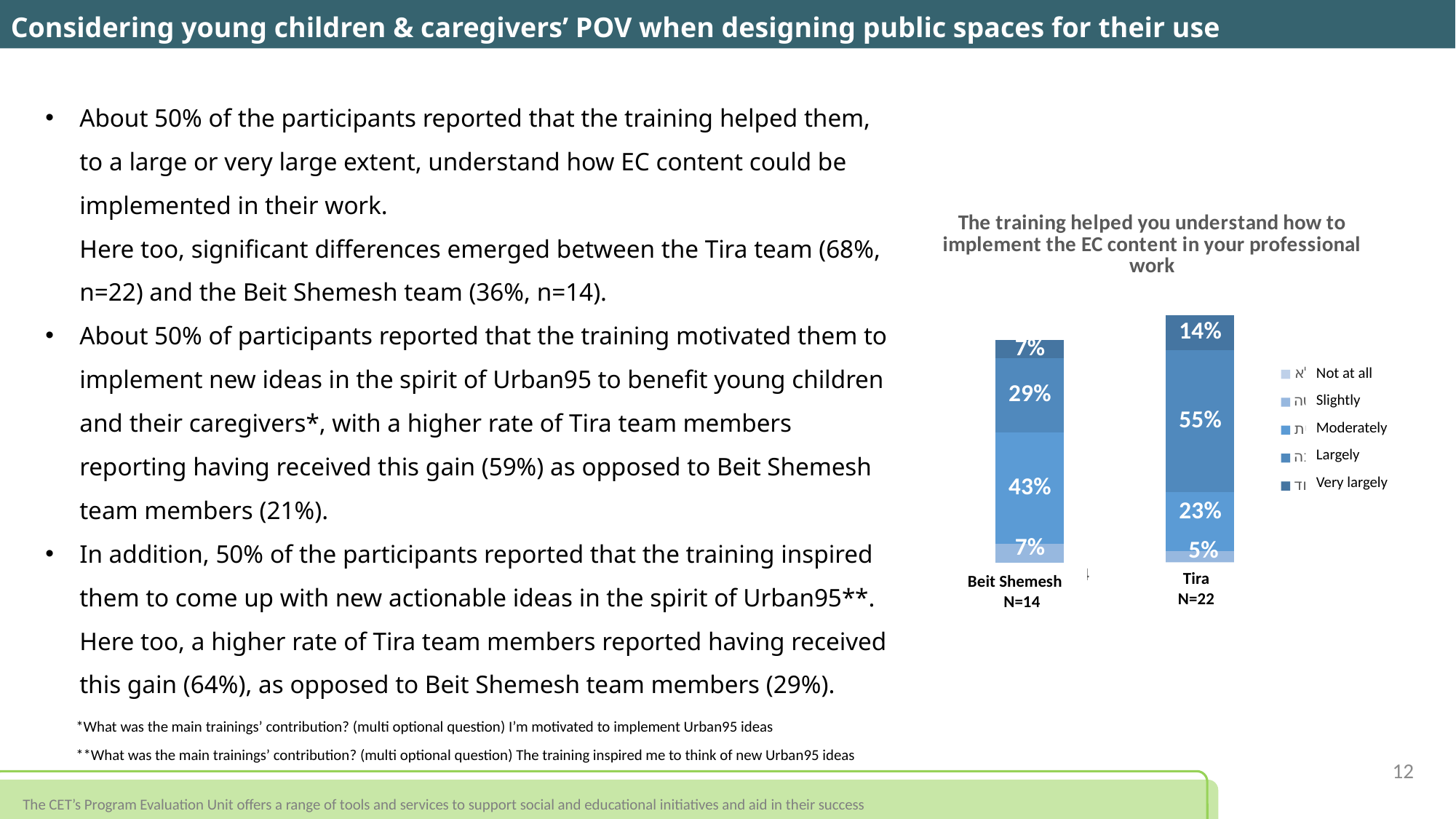
How many bars (teams) does the chart show? 2 What is the title of the chart? The training helped you understand how to implement the EC content in your professional work What is the value of the largest segment in the Beit Shemesh bar? 43% Which team has the larger top (darkest) segment, Beit Shemesh or Tira? Tira What kind of chart is shown on the slide? stacked bar chart What is the value of the second segment from the top in the Beit Shemesh bar? 29% What is the value of the top (darkest) segment of the Tira bar? 14% What is the difference between the 55% segment and the 23% segment in the Tira bar? 32 percentage points What is the value of the bottom segment of the Tira bar? 5% Which bar contains the single largest segment in the chart? Tira What sample size (N) is shown under the Tira bar? N=22 How many entries does the chart legend list? 5